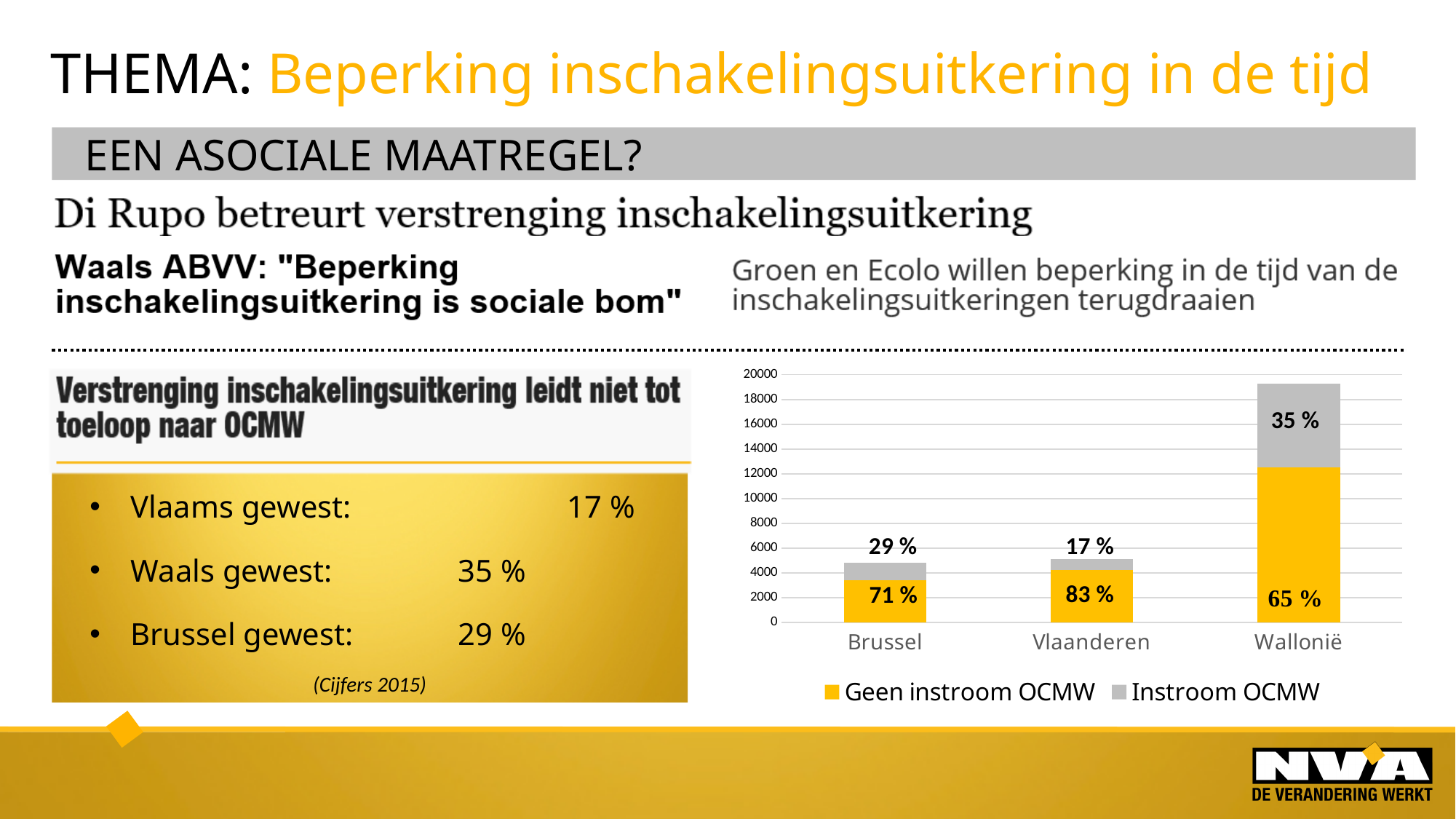
What type of chart is shown on the right of the slide? Stacked bar chart Which region has a higher Geen instroom OCMW percentage label, Vlaanderen or Brussel? Vlaanderen What is the data label for Instroom OCMW in Wallonië? 35 % What is the data label for Geen instroom OCMW in Brussel? 71 % What is the data label for Instroom OCMW in Vlaanderen? 17 % How many series does the chart legend list? 2 Is the total height of the Wallonië bar greater or less than 18000? greater How many regions are shown on the x axis of the chart? 3 Is the total height of the Brussel bar greater or less than 6000? less Which region has the lowest Instroom OCMW percentage label? Vlaanderen What is the data label for Geen instroom OCMW in Wallonië? 65 % Which region has the tallest stacked bar in the chart? Wallonië